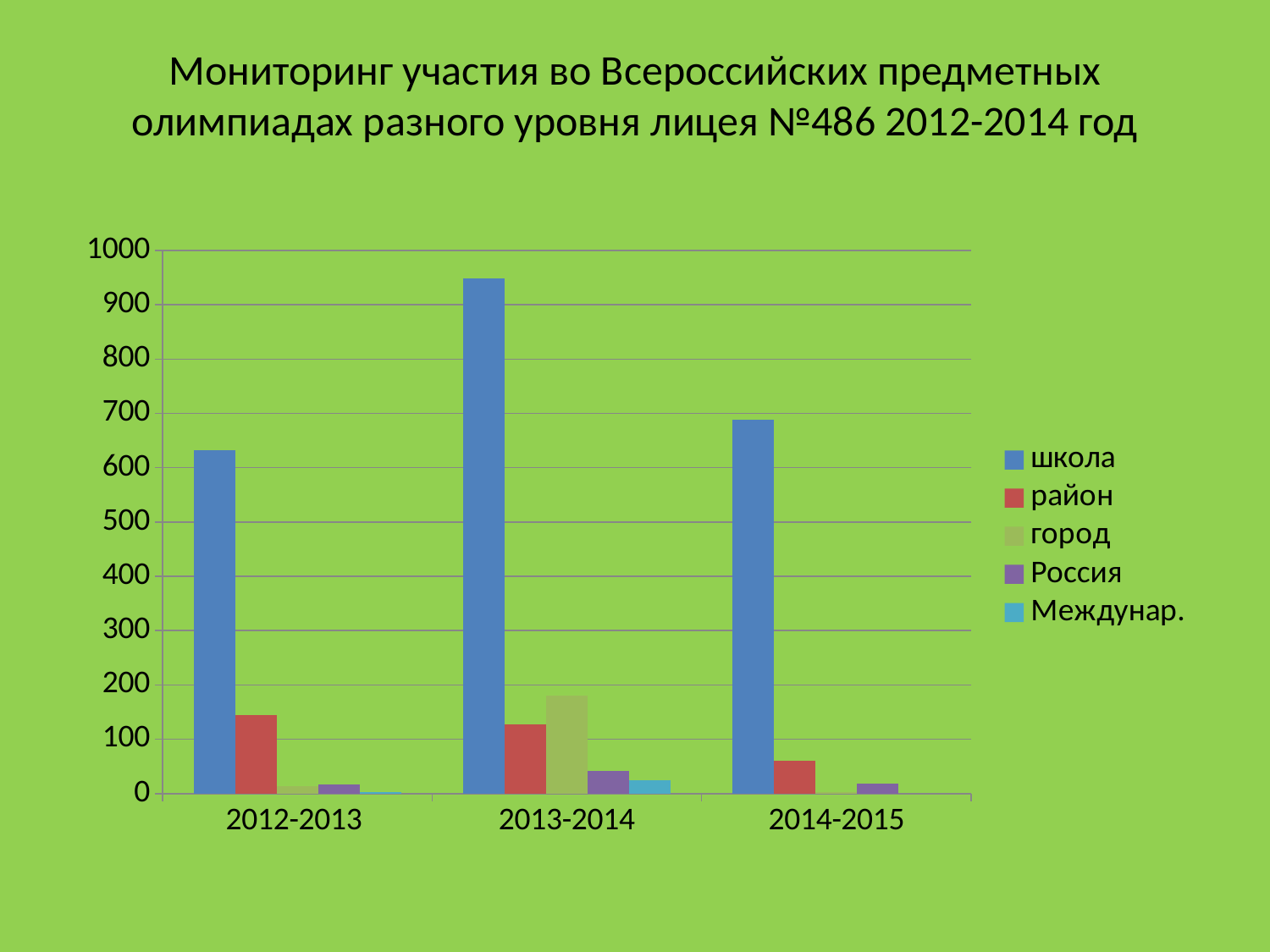
Which is larger: the value for район in 2012-2013 or in 2014-2015? 2012-2013 Do the values for район rise or fall from 2012-2013 to 2014-2015? fall Is the value for школа in 2013-2014 greater or less than 900? greater Is the value for район in 2012-2013 greater or less than 100? greater In which academic year is the value for школа highest? 2013-2014 What kind of chart is shown on the slide? bar chart How many series does the legend list? 5 In which academic year is the value for город highest? 2013-2014 Is the value for школа in 2012-2013 greater or less than 600? greater How many academic-year categories are shown on the x axis? 3 In which academic year is the value for школа lowest? 2012-2013